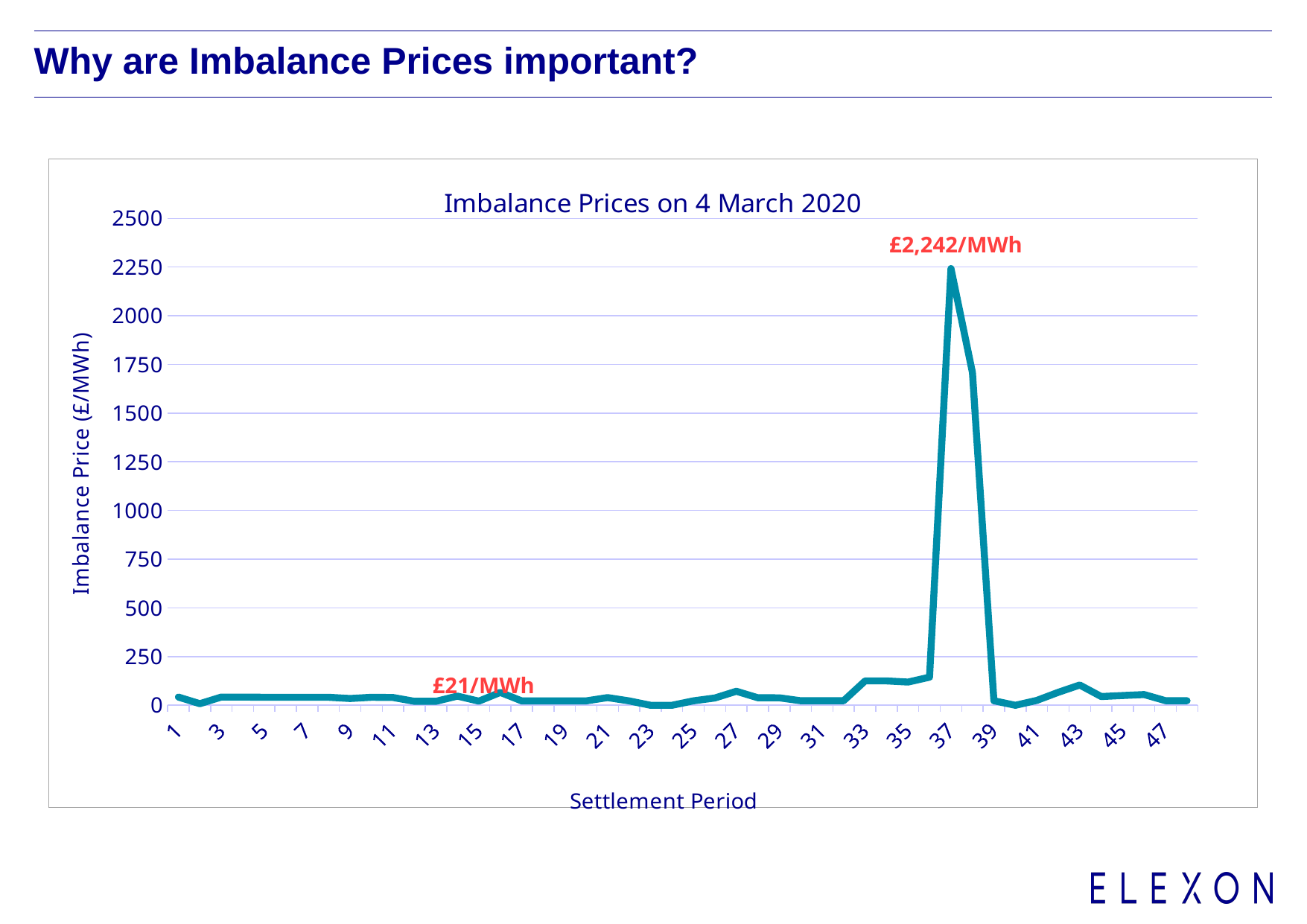
Is the imbalance price at settlement period 37 greater or less than 2000? greater Which settlement period has the larger imbalance price, 37 or 43? 37 At which settlement period does the imbalance price reach its peak? 37 What is the label of the vertical axis? Imbalance Price (£/MWh) What is the title of the chart? Imbalance Prices on 4 March 2020 Is the imbalance price at settlement period 25 greater or less than 250? less Is the imbalance price at settlement period 39 greater or less than 250? less What is the highest imbalance price labelled on the chart? £2,242/MWh What is the difference between the two labelled values, £2,242/MWh and £21/MWh? £2,221/MWh What kind of chart is shown on the slide? Line chart What is the highest value shown on the vertical axis? 2500